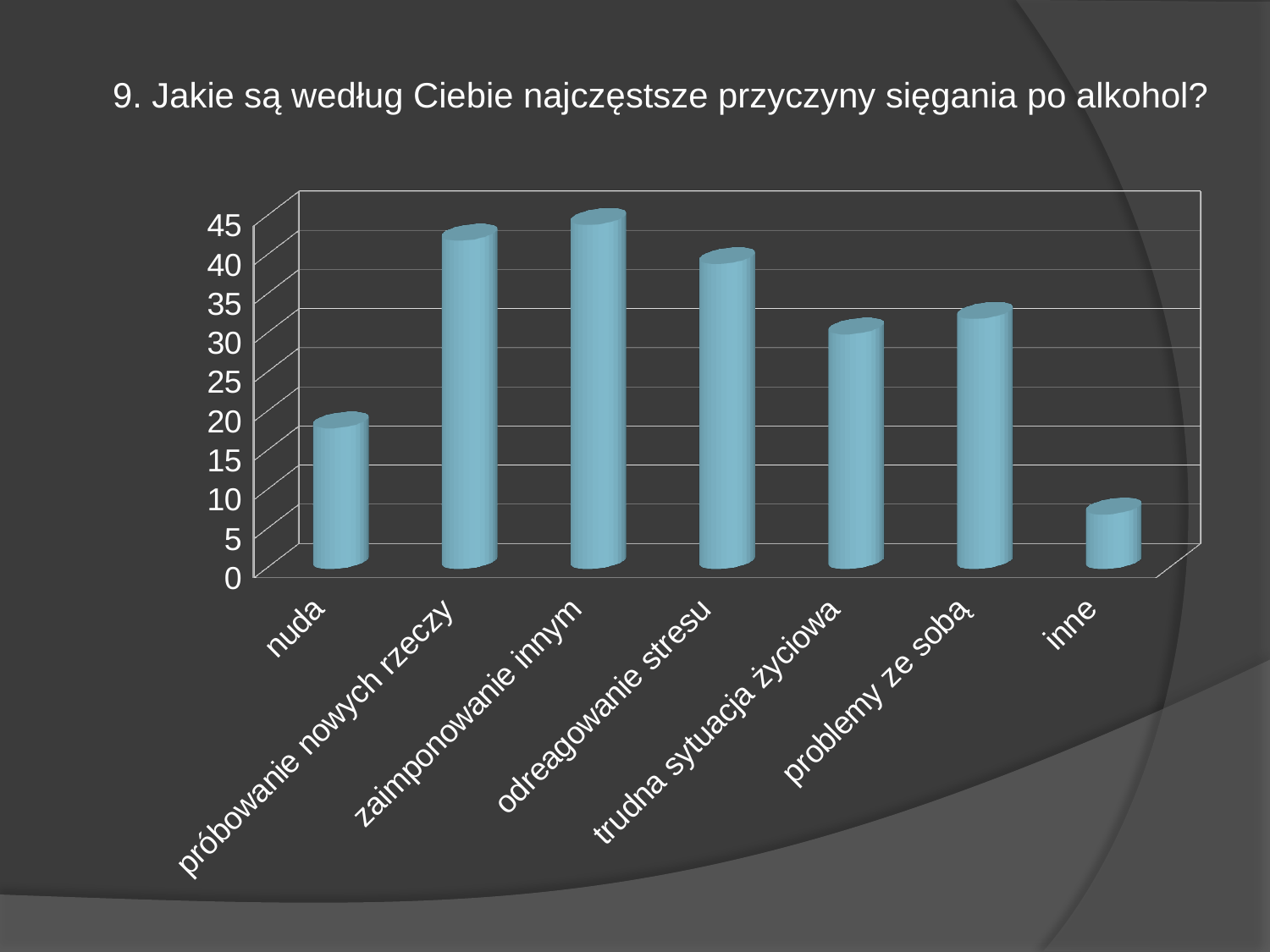
What is the title of the slide above the chart? 9. Jakie są według Ciebie najczęstsze przyczyny sięgania po alkohol? Is the value for inne greater or less than 10? less Is the value for trudna sytuacja życiowa greater or less than 25? greater Which category has the lowest value in the chart? inne Which is larger, the value for nuda or the value for inne? nuda Is the value for próbowanie nowych rzeczy greater or less than 40? greater Which category has the highest value in the chart? zaimponowanie innym What kind of chart is shown on the slide? bar chart Which is larger, the value for odreagowanie stresu or the value for trudna sytuacja życiowa? odreagowanie stresu How many categories are shown on the x axis of the chart? 7